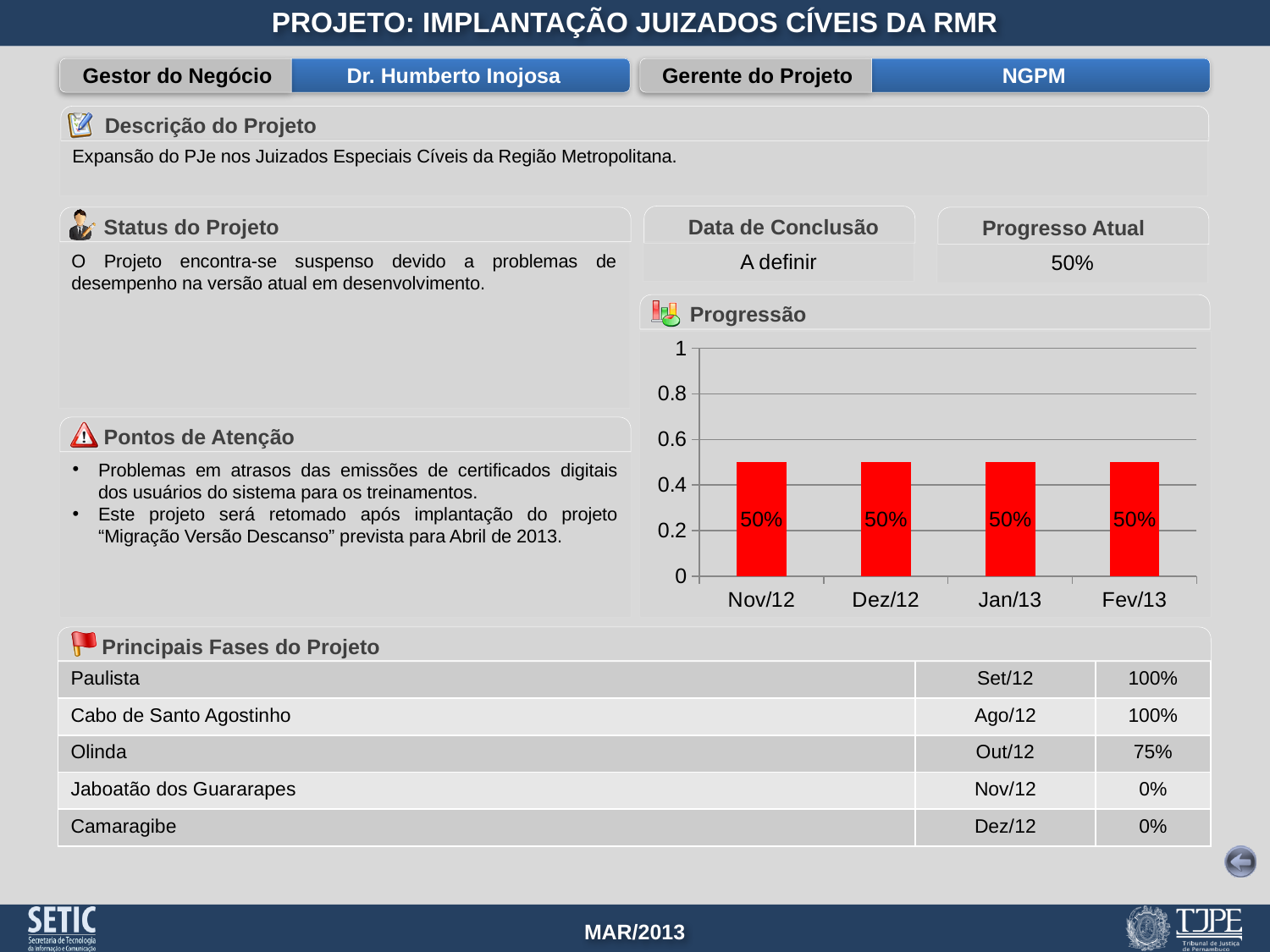
What is the value shown for Dez/12 in the Progressão chart? 50% What kind of chart is the Progressão chart? bar chart What colour are the bars in the Progressão chart? red What is the value shown for Nov/12 in the Progressão chart? 50% What is the value shown for Jan/13 in the Progressão chart? 50% Is the value for Dez/12 in the Progressão chart greater or less than 0.6 on the y axis? less Is the value for Jan/13 in the Progressão chart greater or less than 0.4 on the y axis? greater What is the difference between the values for Nov/12 and Fev/13 in the Progressão chart? 0% What is the value shown for Fev/13 in the Progressão chart? 50% How many categories are plotted on the x axis of the Progressão chart? 4 Do the values in the Progressão chart rise, fall or stay flat from Nov/12 to Fev/13? stay flat What is the title of the chart on the slide? Progressão